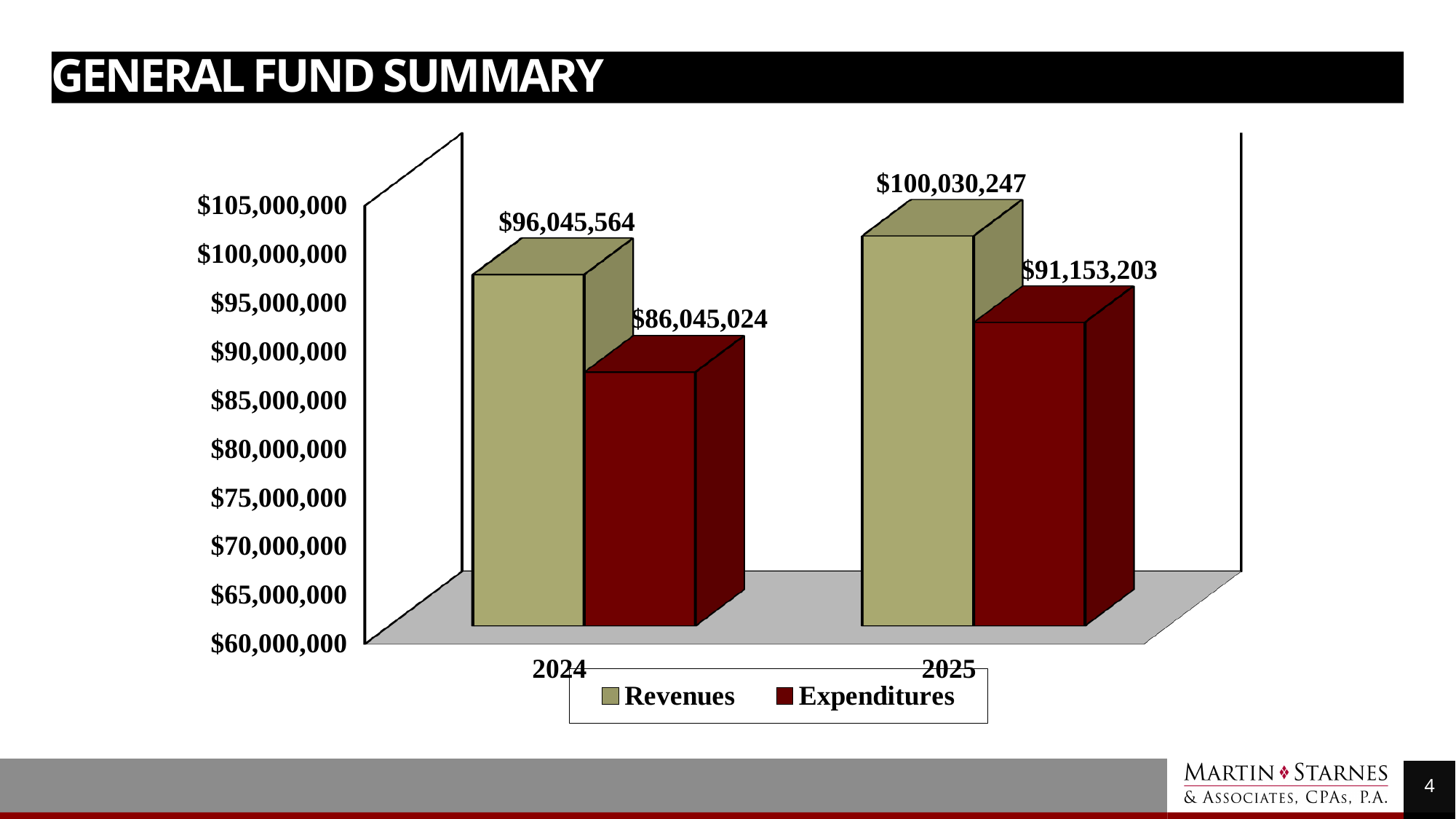
What kind of chart is shown on the slide? Bar chart Which bar has the highest value on the chart? Revenues for 2025 What is the difference between Revenues and Expenditures in 2024? $10,000,540 Which bar has the lowest value on the chart? Expenditures for 2024 What is the value of Revenues for 2025? $100,030,247 By how much did Expenditures increase from 2024 to 2025? $5,108,179 What is the value of Revenues for 2024? $96,045,564 How many series does the legend list? 2 What is the value of Expenditures for 2024? $86,045,024 Do Revenues rise or fall from 2024 to 2025? Rise What is the value of Expenditures for 2025? $91,153,203 Which is larger in 2025, Revenues or Expenditures? Revenues